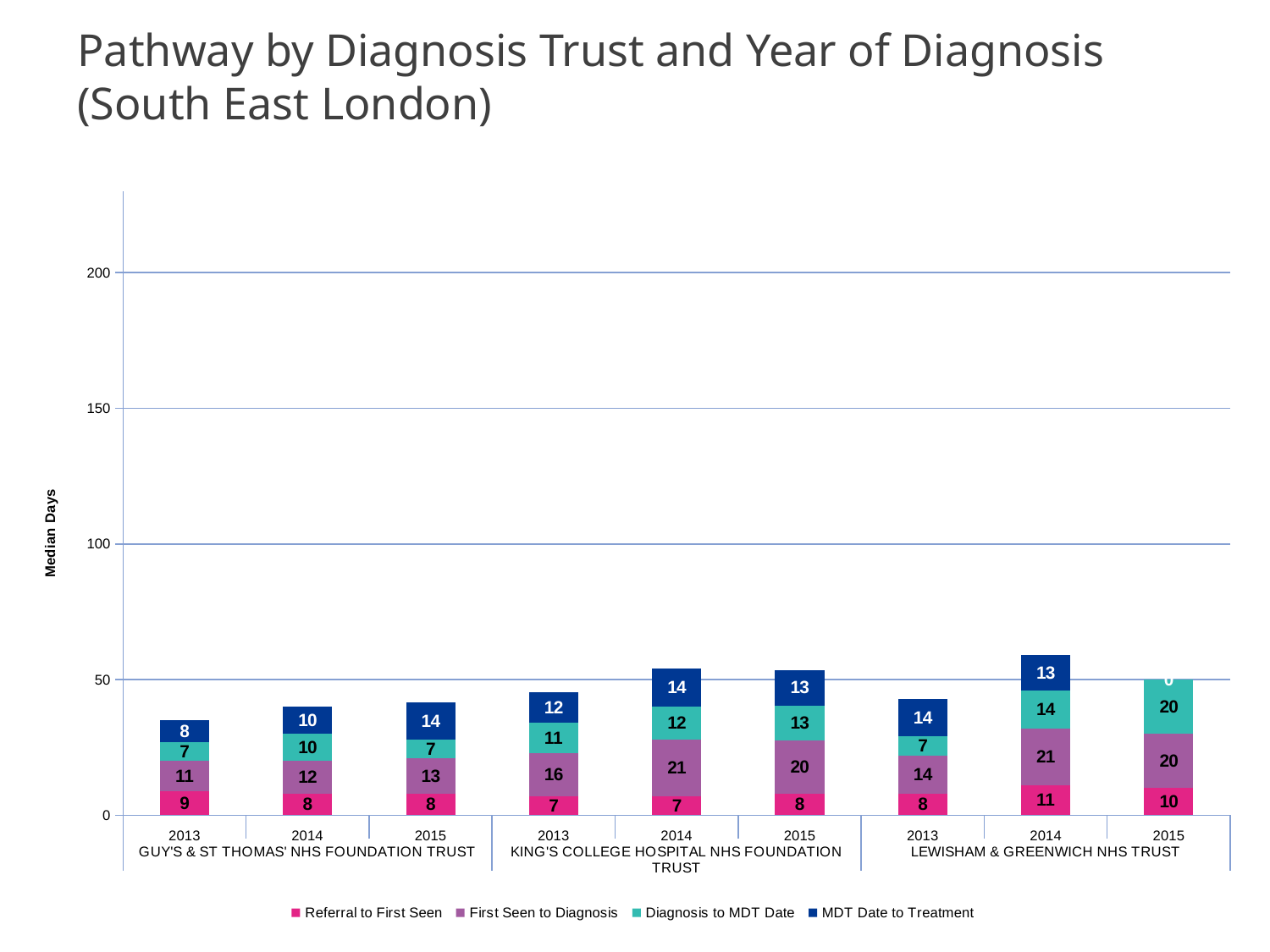
What is the total of the stacked bar for Guy's & St Thomas' NHS Foundation Trust in 2013? 35 What is the Referral to First Seen value for Guy's & St Thomas' NHS Foundation Trust in 2013? 9 What is the total of the stacked bar for King's College Hospital NHS Foundation Trust in 2014? 54 Is the total for King's College Hospital NHS Foundation Trust in 2015 greater or less than 100? less What is the MDT Date to Treatment value for Lewisham & Greenwich NHS Trust in 2013? 14 How many series does the legend list? 4 What kind of chart is shown on the slide? Stacked bar chart What is the First Seen to Diagnosis value for King's College Hospital NHS Foundation Trust in 2014? 21 How much higher is the First Seen to Diagnosis value for King's College Hospital NHS Foundation Trust in 2014 than in 2013? 5 What is the title of the vertical axis? Median Days Which is larger: the Diagnosis to MDT Date value for Lewisham & Greenwich NHS Trust in 2014 or for Guy's & St Thomas' NHS Foundation Trust in 2014? Lewisham & Greenwich NHS Trust in 2014 How many stacked bars are plotted in the chart? 9